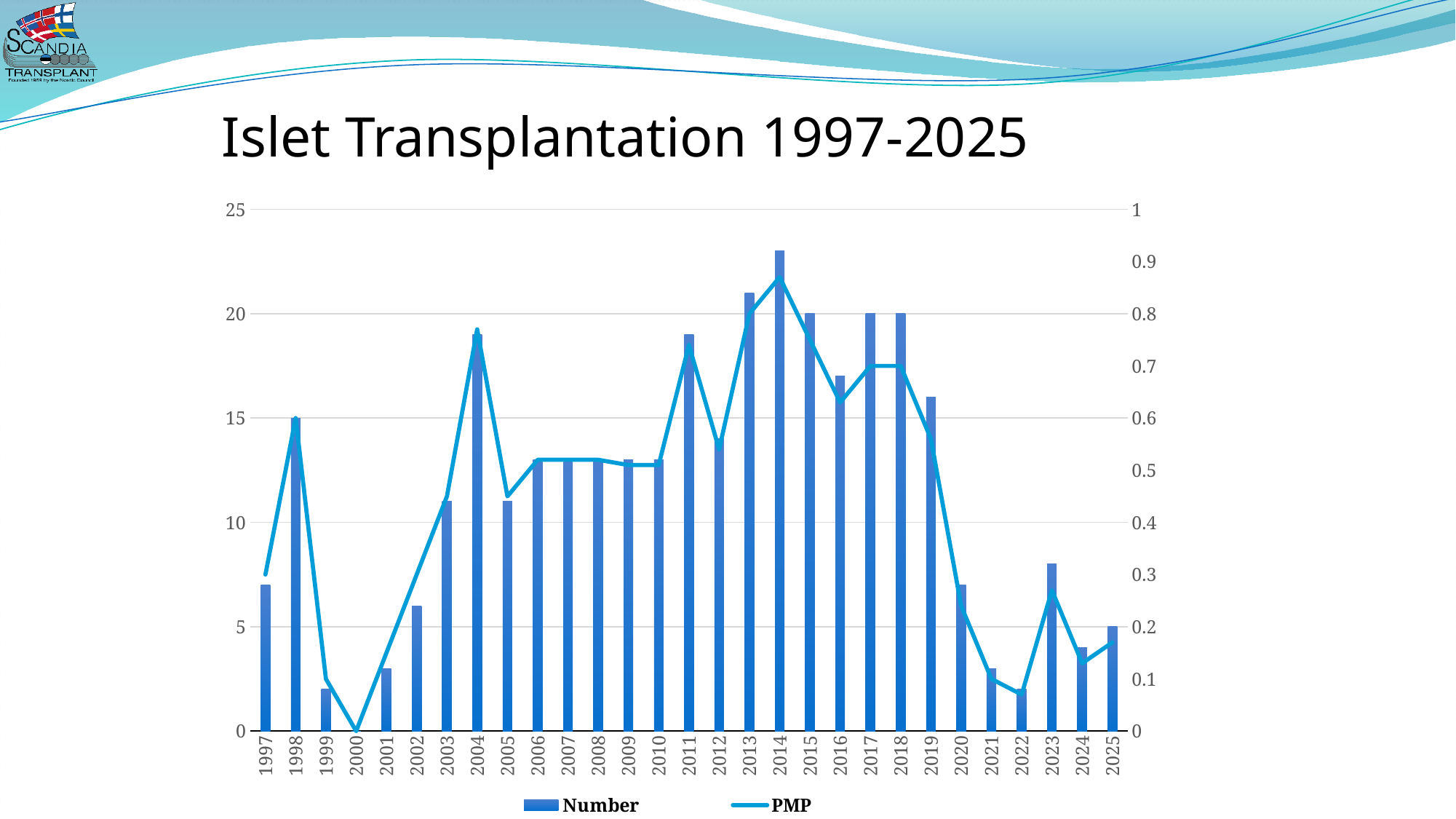
Is the Number value for 2014 greater or less than 20? greater What is the Number value for 1998? 15 How many series does the legend list? 2 Is the Number value for 2021 greater or less than 5? less What is the difference between the Number values for 2018 and 2025? 15 What is the Number value for 2017? 20 Which year has the highest Number bar? 2014 What kind of chart is used for the Number series? Bar chart Which year has the lowest Number bar? 2000 How many years are shown on the x axis? 29 What is the title of the chart? Islet Transplantation 1997-2025 What is the Number value for 2025? 5